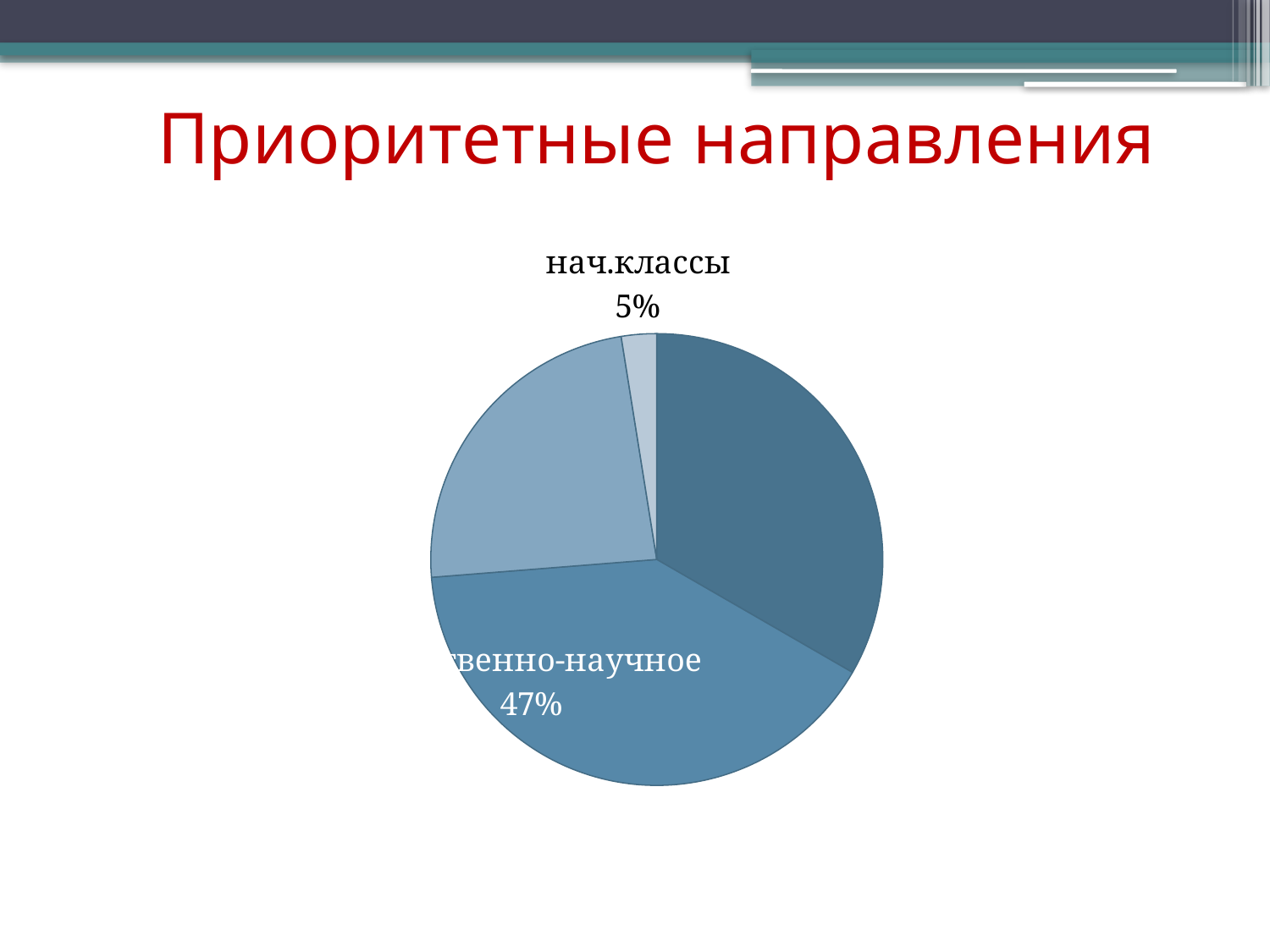
What percentage is shown for нач.классы? 5% Which slice of the pie chart is the smallest? нач.классы What is the title of the slide containing the chart? Приоритетные направления How many slices in the pie chart have a percentage label printed? 2 Which is larger: the slice labelled 47% or the нач.классы slice? the slice labelled 47% Is the нач.классы slice greater or less than 10% of the pie? less What is the difference between the slice labelled 47% and the нач.классы slice? 42% How many slices does the pie chart have? 4 What type of chart is shown on the slide? pie chart What share of the pie does нач.классы represent? 5%